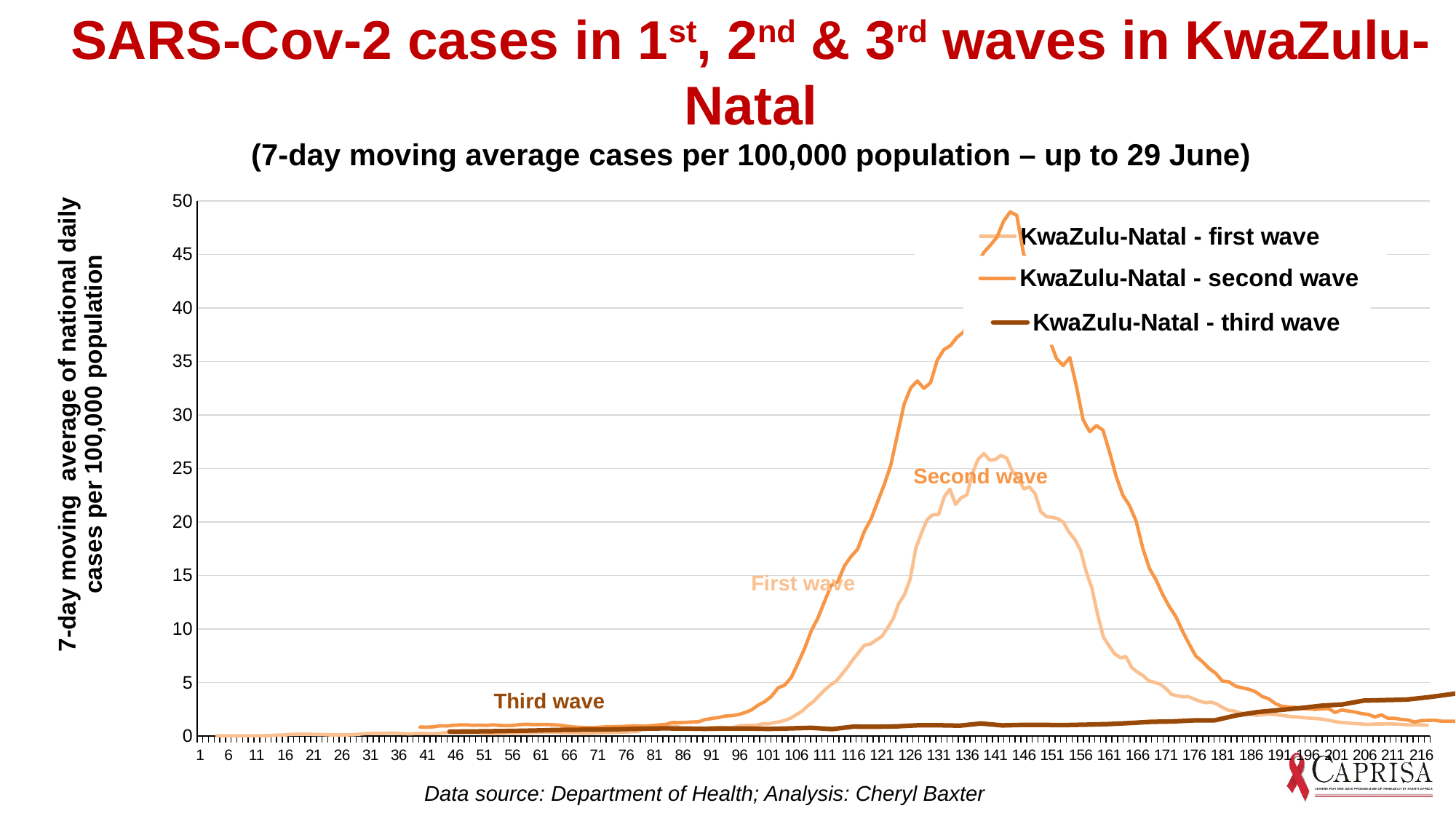
What is the highest value shown on the y axis? 50 What kind of chart is shown on the slide? line chart Which is larger at day 141: the first wave or the second wave? second wave Is the peak value of the first wave greater or less than 30? less Is the peak value of the second wave greater or less than 45? greater Is the value of the second wave at day 131 greater or less than 30? greater What is the subtitle shown below the chart title? (7-day moving average cases per 100,000 population – up to 29 June) Does the third wave line rise or fall overall from day 46 to day 216? rise How many series does the legend list? 3 Which wave reaches the highest peak value? KwaZulu-Natal - second wave Which wave has the lowest peak value? KwaZulu-Natal - third wave